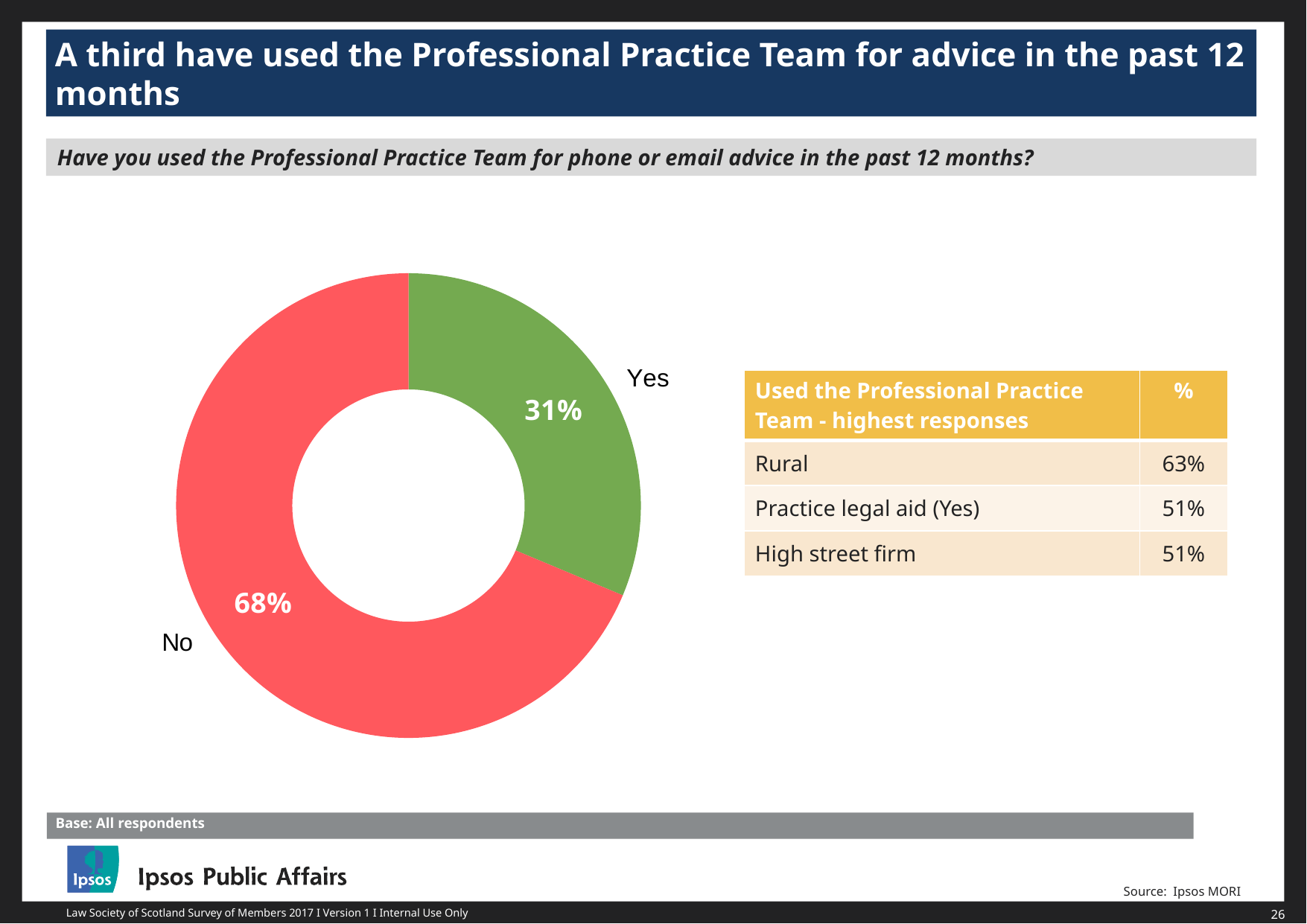
What type of chart is used to show the Yes/No responses? Donut (pie) chart How many categories are shown in the donut chart? 2 In the table, which group has the highest percentage of use of the Professional Practice Team? Rural What colour is the Yes slice in the donut chart? Green What percentage of respondents answered Yes in the donut chart? 31% What percentage of respondents answered No in the donut chart? 68% What colour is the No slice in the donut chart? Red In the table, what percentage of Rural respondents used the Professional Practice Team? 63% Which response has the larger share of the donut chart, Yes or No? No In the table, what percentage is shown for High street firm? 51% Which category has the smallest slice in the donut chart? Yes What is the difference in percentage points between the No and Yes slices? 37